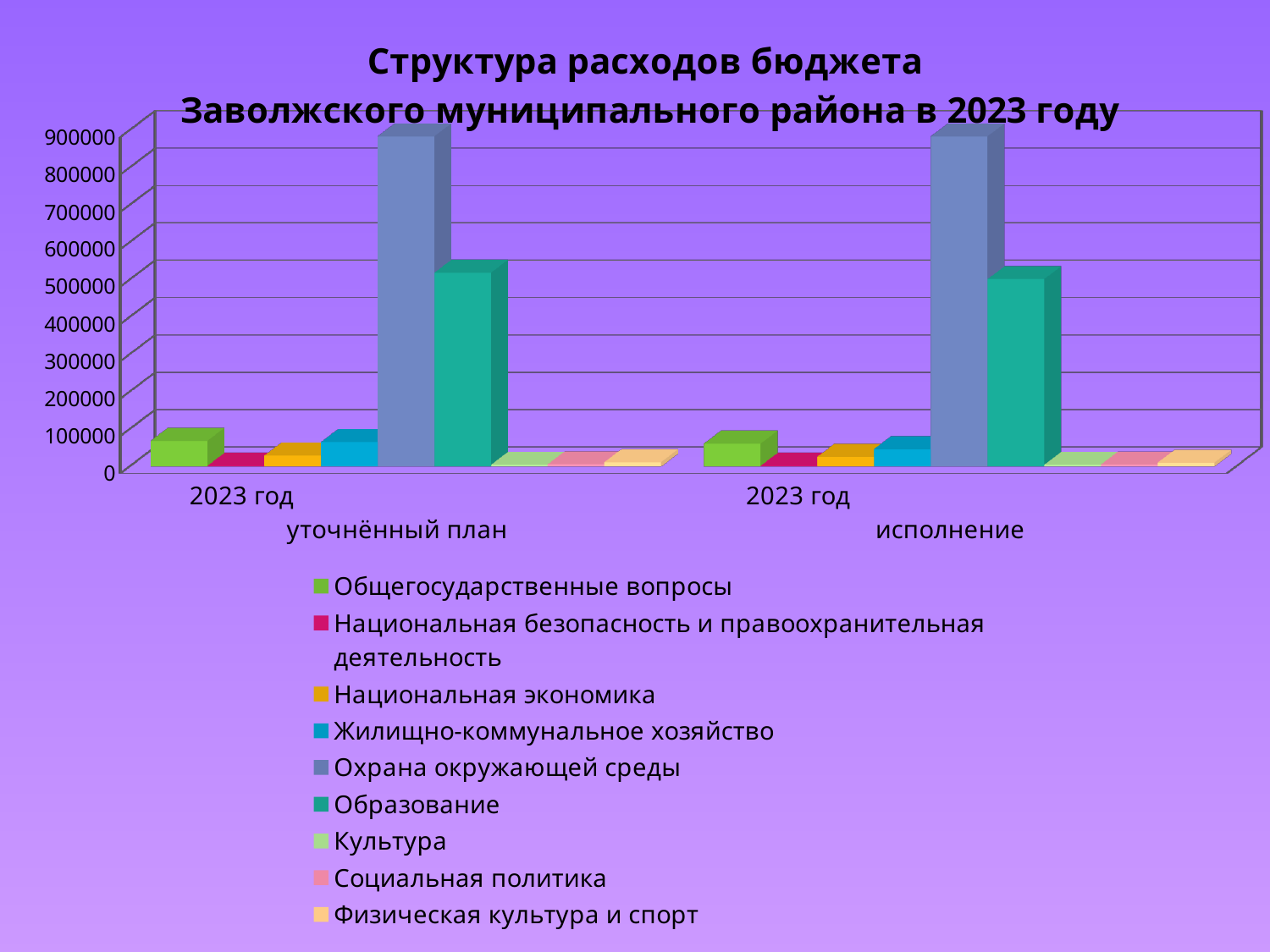
Is the value for Охрана окружающей среды in "2023 год уточнённый план" greater or less than 700000? greater Is the value for Образование in "2023 год исполнение" greater or less than 400000? greater How many series does the legend list? 9 What kind of chart is shown on the slide? bar chart Which series has the highest value in the "2023 год уточнённый план" category? Охрана окружающей среды In the "2023 год уточнённый план" category, which is larger: Охрана окружающей среды or Образование? Охрана окружающей среды Is the value for Общегосударственные вопросы in "2023 год исполнение" greater or less than 200000? less How many categories are shown on the x axis? 2 What is the title of the chart? Структура расходов бюджета Заволжского муниципального района в 2023 году In the "2023 год исполнение" category, which is larger: Образование or Жилищно-коммунальное хозяйство? Образование Which series has the highest value in the "2023 год исполнение" category? Охрана окружающей среды